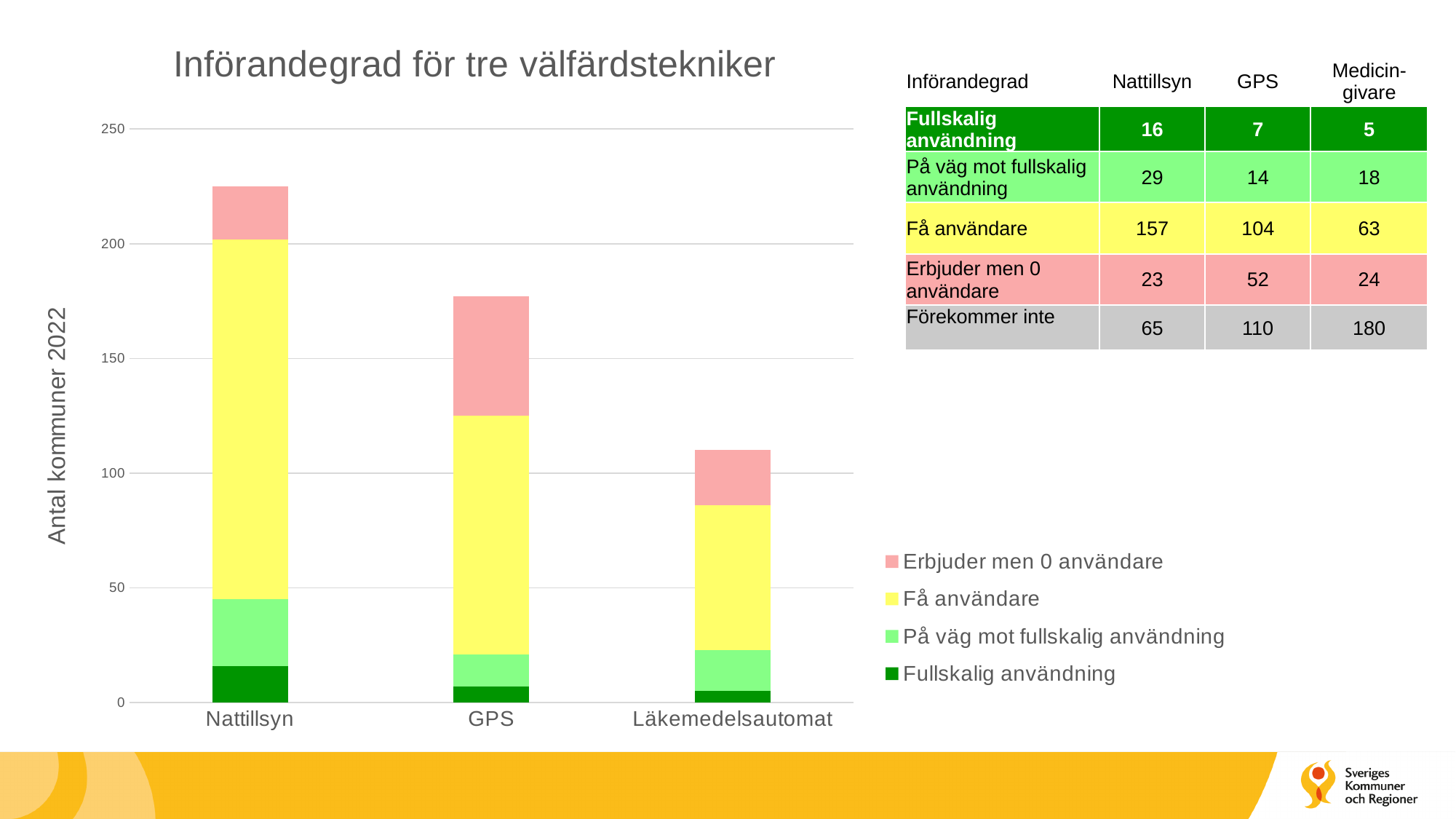
What is the value of 'Få användare' for Nattillsyn? 157 What is the difference between the 'Få användare' values for Nattillsyn and GPS? 53 What is the total of the stacked bar for GPS? 177 How many series does the chart legend list? 4 What is the value of 'Erbjuder men 0 användare' for GPS? 52 How many categories are shown on the x axis of the chart? 3 Is the 'Erbjuder men 0 användare' value larger for GPS or for Nattillsyn? GPS What kind of chart is shown on the slide? Stacked bar chart Which category has the shortest stacked bar? Läkemedelsautomat What is the total of the stacked bar for Nattillsyn? 225 Which category has the tallest stacked bar? Nattillsyn Is the total height of the Läkemedelsautomat bar greater or less than 100? greater